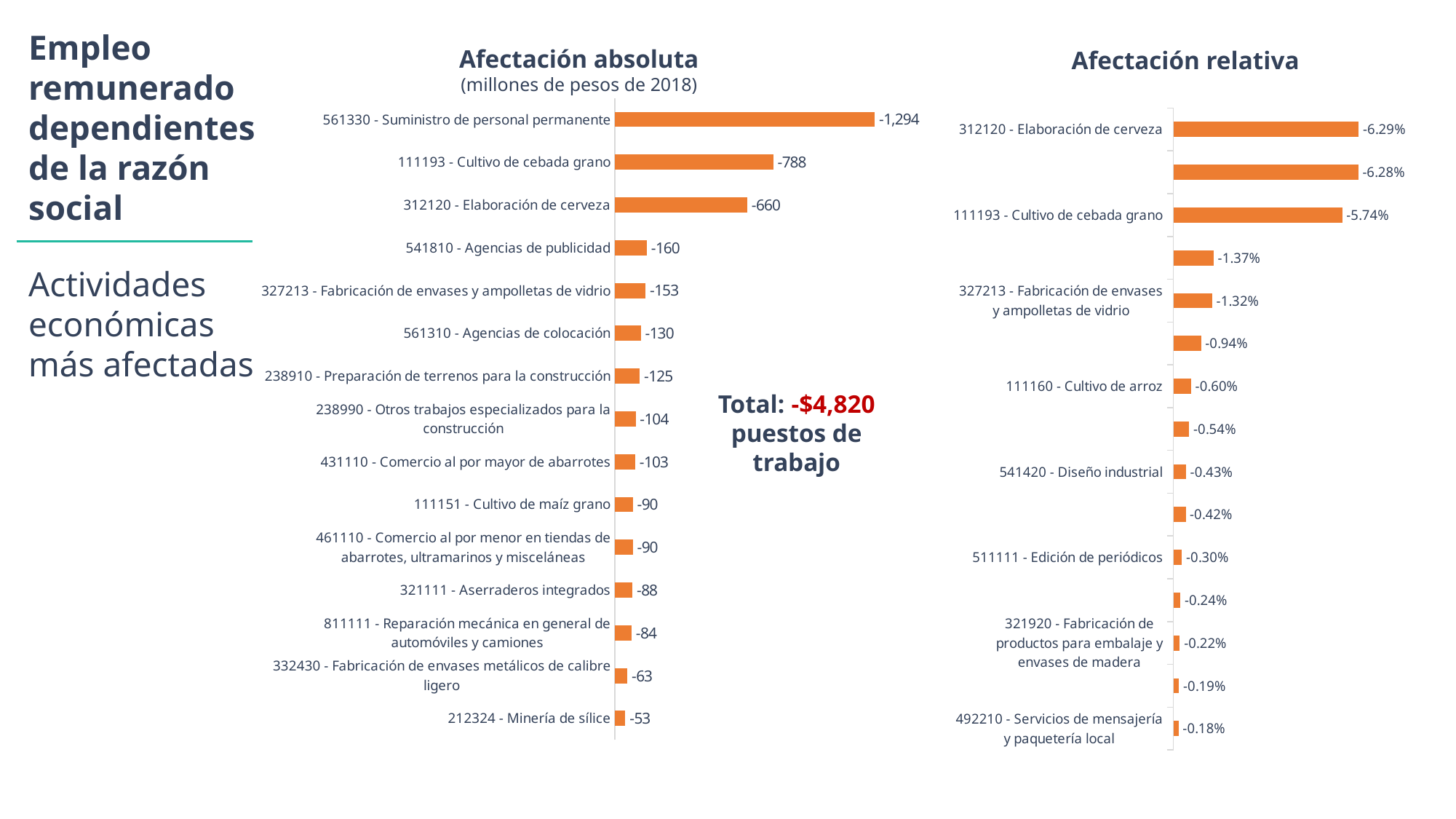
In the 'Afectación relativa' chart, which labelled category has the lowest (most negative) value? 312120 - Elaboración de cerveza What unit is given in the subtitle of the 'Afectación absoluta' chart? millones de pesos de 2018 In the 'Afectación absoluta' chart, what is the difference between the values for 561330 - Suministro de personal permanente and 111193 - Cultivo de cebada grano? 506 In the 'Afectación relativa' chart, what is the value for 111193 - Cultivo de cebada grano? -5.74% In the 'Afectación absoluta' chart, which has a larger loss: 541810 - Agencias de publicidad or 561310 - Agencias de colocación? 541810 - Agencias de publicidad In the 'Afectación absoluta' chart, what is the value for 561330 - Suministro de personal permanente? -1,294 In the 'Afectación absoluta' chart, which category has the lowest (most negative) value? 561330 - Suministro de personal permanente In the 'Afectación absoluta' chart, what is the value for 212324 - Minería de sílice? -53 How many categories are shown in the 'Afectación absoluta' chart? 15 What kind of chart is the 'Afectación relativa' chart? Bar chart In the 'Afectación absoluta' chart, what is the value for 312120 - Elaboración de cerveza? -660 In the 'Afectación relativa' chart, what is the value for 541420 - Diseño industrial? -0.43%